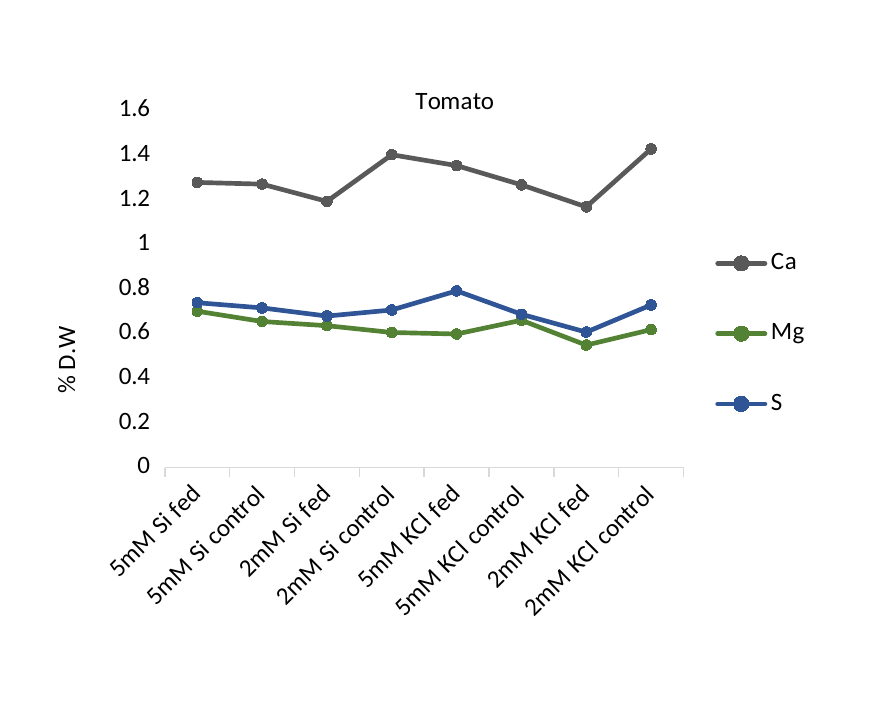
What type of chart is shown on the slide? line chart What is the label of the y axis? % D.W How many series does the legend list? 3 What is the title of the chart? Tomato For which category is the S series highest? 5mM KCl fed How many categories are shown along the x axis? 8 Does the Ca series rise or fall from 2mM KCl fed to 2mM KCl control? rise Is the Mg value for 2mM KCl fed greater or less than 0.6? less For which category is the S series lowest? 2mM KCl fed At 5mM KCl fed, which series has the larger value, S or Mg? S For which category is the Mg series lowest? 2mM KCl fed Is the Ca value for 5mM Si fed greater or less than 1.2? greater